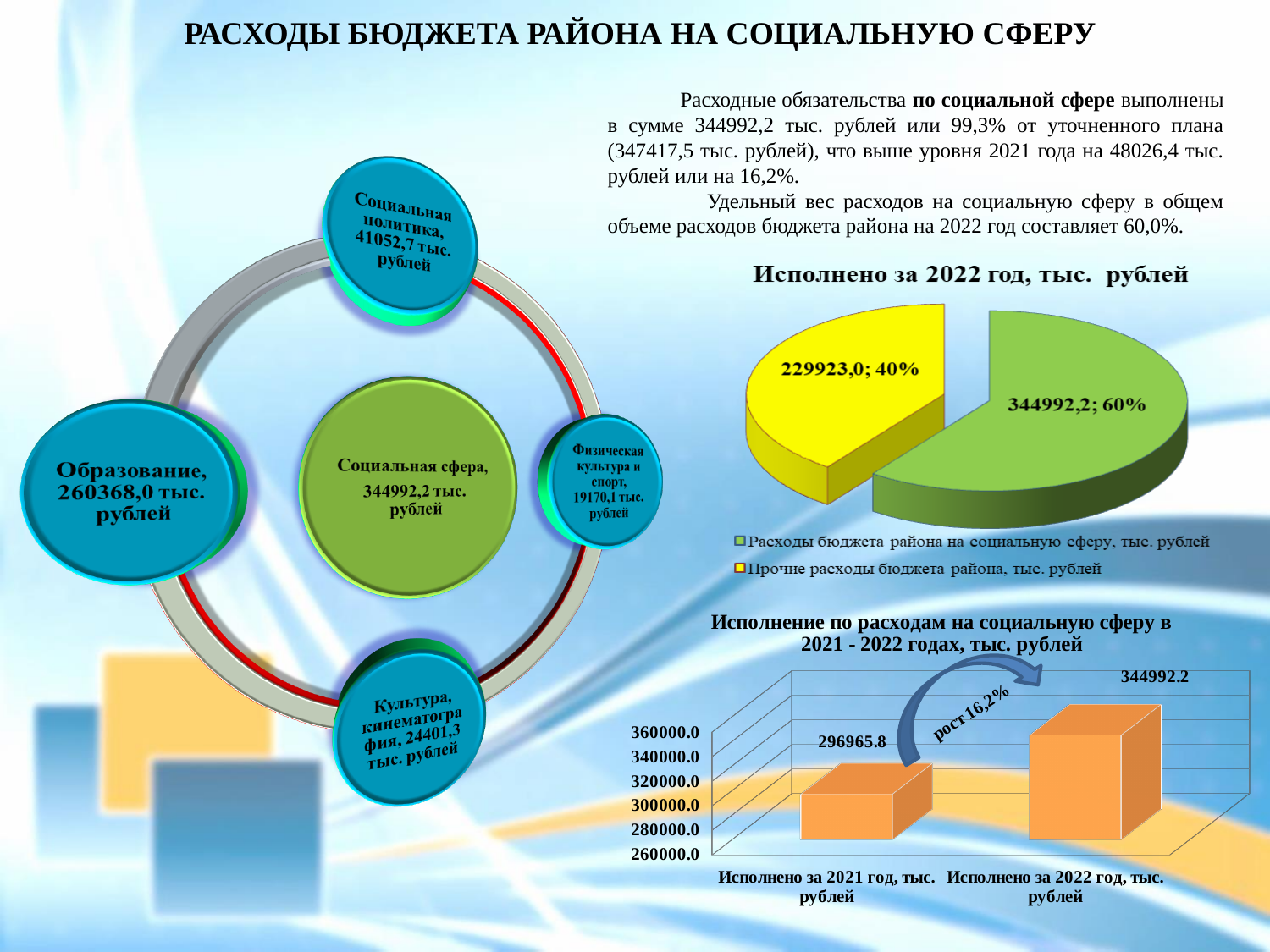
In the pie chart "Исполнено за 2022 год, тыс. рублей", what value is shown for the slice "Расходы бюджета района на социальную сферу, тыс. рублей"? 344992,2 How many entries does the legend of the pie chart "Исполнено за 2022 год, тыс. рублей" list? 2 In the pie chart "Исполнено за 2022 год, тыс. рублей", what share of the pie does the slice "Расходы бюджета района на социальную сферу" take? 60% In the pie chart "Исполнено за 2022 год, тыс. рублей", what value is shown for the slice "Прочие расходы бюджета района, тыс. рублей"? 229923,0 In the pie chart "Исполнено за 2022 год, тыс. рублей", which slice is the largest? Расходы бюджета района на социальную сферу, тыс. рублей What kind of chart is "Исполнение по расходам на социальную сферу в 2021 - 2022 годах, тыс. рублей"? Bar chart In the pie chart "Исполнено за 2022 год, тыс. рублей", what colour is the slice for "Прочие расходы бюджета района"? Yellow In the bar chart "Исполнение по расходам на социальную сферу в 2021 - 2022 годах", which bar is higher, 2021 or 2022? Исполнено за 2022 год In the bar chart "Исполнение по расходам на социальную сферу в 2021 - 2022 годах", do the values rise or fall from 2021 to 2022? Rise In the bar chart "Исполнение по расходам на социальную сферу в 2021 - 2022 годах", what is the value for "Исполнено за 2021 год, тыс. рублей"? 296965.8 In the bar chart "Исполнение по расходам на социальную сферу в 2021 - 2022 годах", what is the value for "Исполнено за 2022 год, тыс. рублей"? 344992.2 In the pie chart "Исполнено за 2022 год, тыс. рублей", what share of the pie does the slice "Прочие расходы бюджета района" take? 40%